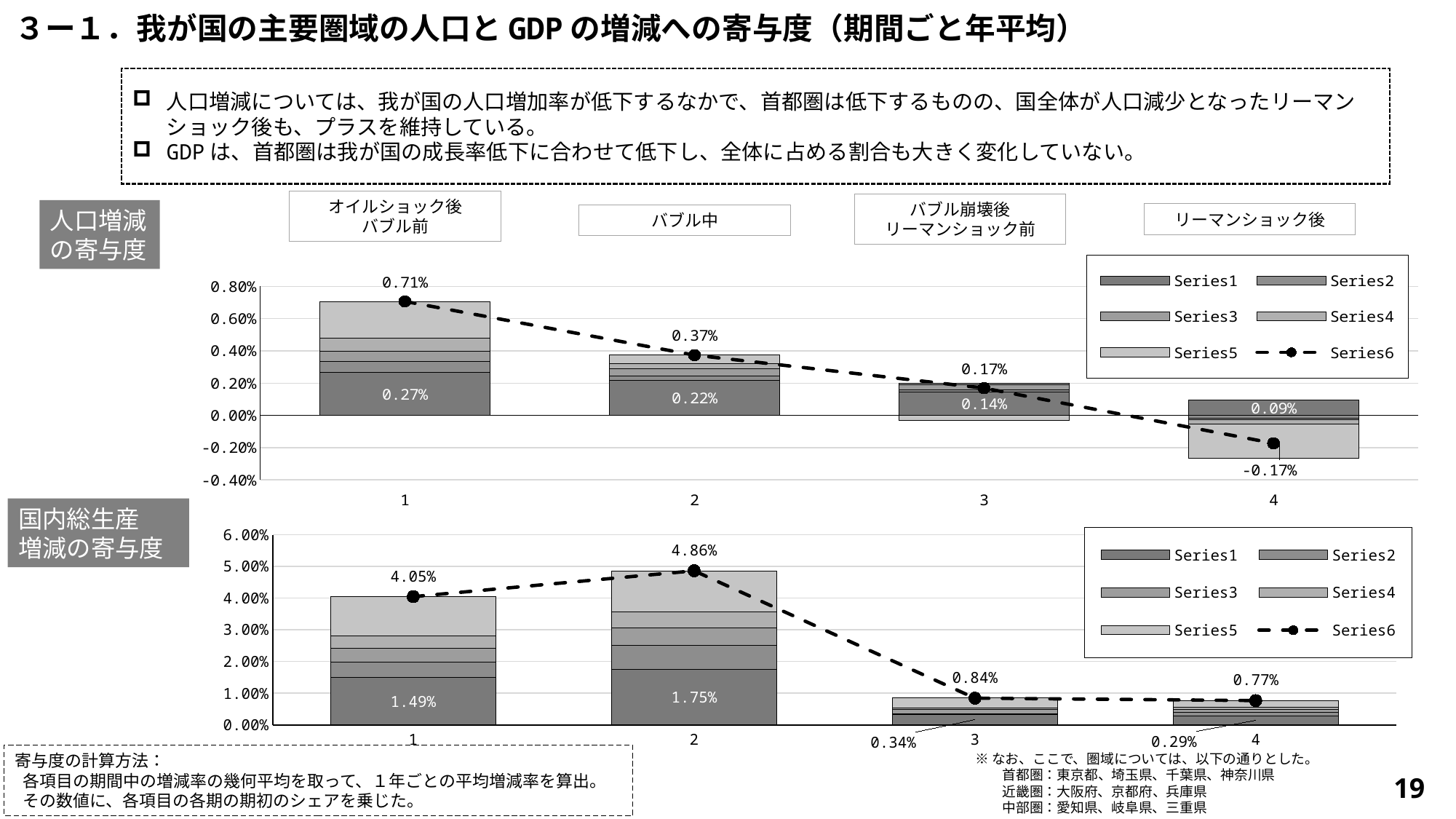
In the top chart (人口増減の寄与度), what is the difference between the Series6 values at category 1 and category 2? 0.34% In the bottom chart (国内総生産増減の寄与度), what is the Series6 value at category 2? 4.86% In the bottom chart (国内総生産増減の寄与度), at which category is the Series6 value lowest? 4 In the top chart (人口増減の寄与度), does the Series6 line rise or fall from category 1 to category 4? fall In the bottom chart (国内総生産増減の寄与度), which is larger, the Series1 value at category 1 or at category 2? category 2 In the top chart (人口増減の寄与度), what is the Series1 value at category 2? 0.22% What kind of chart is the top chart (人口増減の寄与度)? stacked bar chart with a line How many series does the legend of the bottom chart (国内総生産増減の寄与度) list? 6 In the top chart (人口増減の寄与度), what is the Series6 value at category 1? 0.71% In the bottom chart (国内総生産増減の寄与度), what is the Series1 value at category 3? 0.34% In the top chart (人口増減の寄与度), what is the Series6 value at category 4? -0.17% In the top chart (人口増減の寄与度), at which category is the Series6 value highest? 1